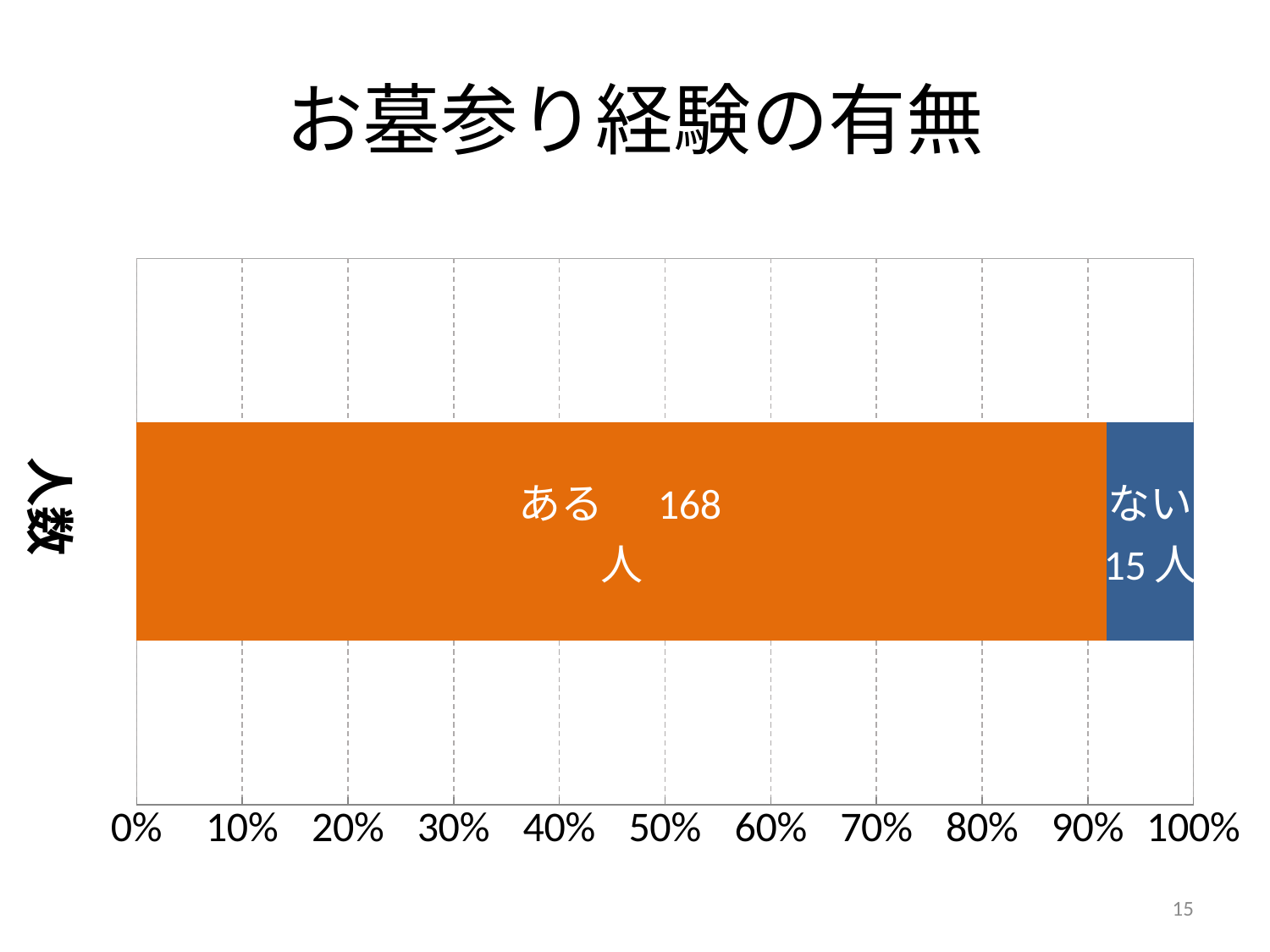
What colour is the segment for ある? orange How many people answered ない (no experience)? 15人 How many segments (categories) does the bar contain? 2 What kind of chart is shown on the slide? bar chart How many people answered ある (have experience)? 168人 Is the share of the bar for ない greater or less than 10%? less Is the share of the bar for ある greater or less than 90%? greater What is the total number of people across both segments of the bar? 183人 What is the difference in the number of people between ある and ない? 153人 Which category has the larger number of people, ある or ない? ある What is the title of the chart? お墓参り経験の有無 Which category has the smallest number of people? ない